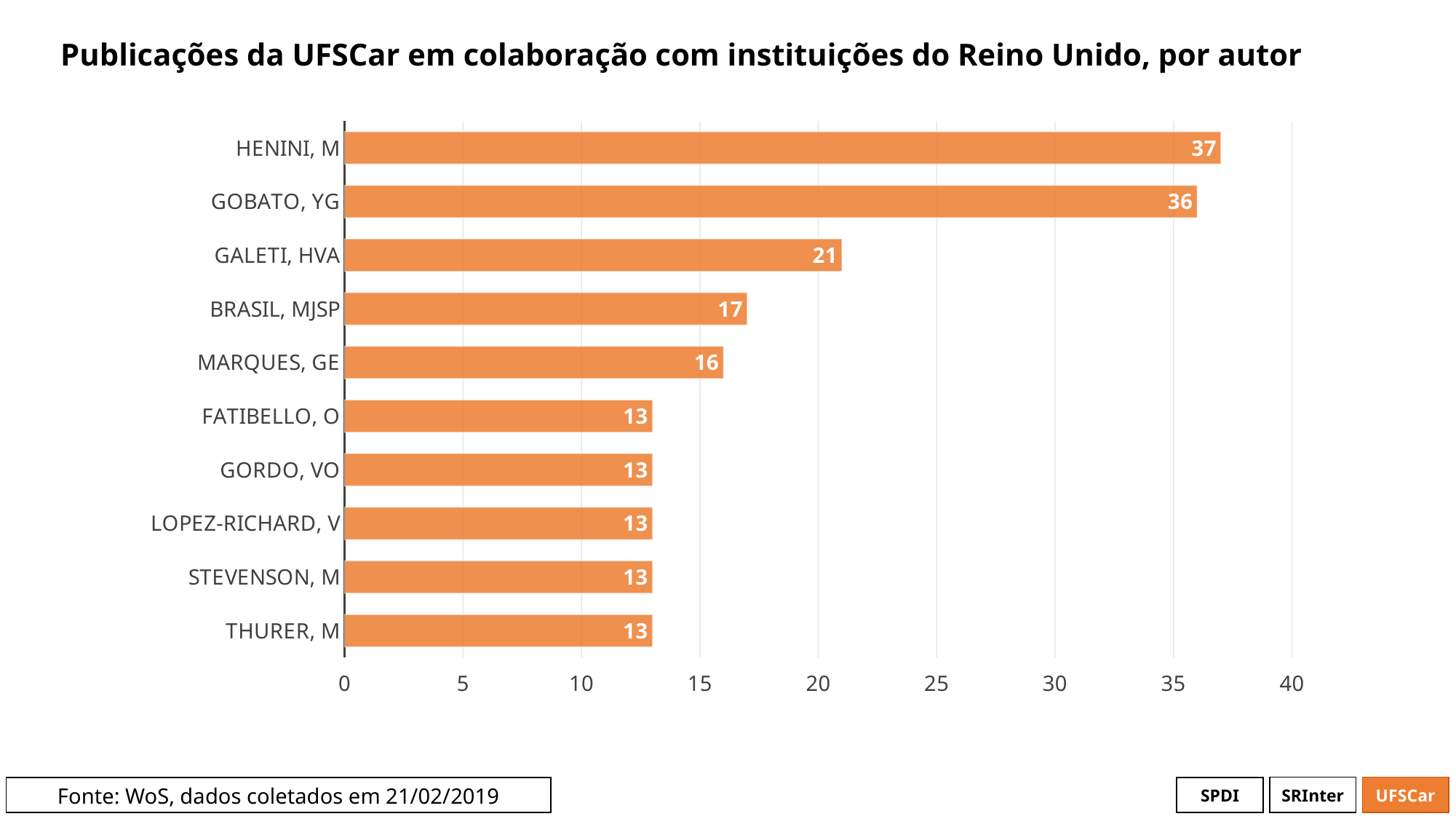
Which is larger, the value for BRASIL, MJSP or the value for MARQUES, GE? BRASIL, MJSP What is the title of the chart? Publicações da UFSCar em colaboração com instituições do Reino Unido, por autor What is the value for MARQUES, GE? 16 What kind of chart is shown on the slide? Bar chart What is the value for HENINI, M? 37 Is the value for GOBATO, YG greater or less than 35? greater What is the value for GALETI, HVA? 21 What is the difference between the values for GALETI, HVA and BRASIL, MJSP? 4 How many authors are shown in the chart? 10 What is the difference between the values for HENINI, M and GOBATO, YG? 1 Which author has the highest number of publications? HENINI, M How many authors have a value of 13? 5